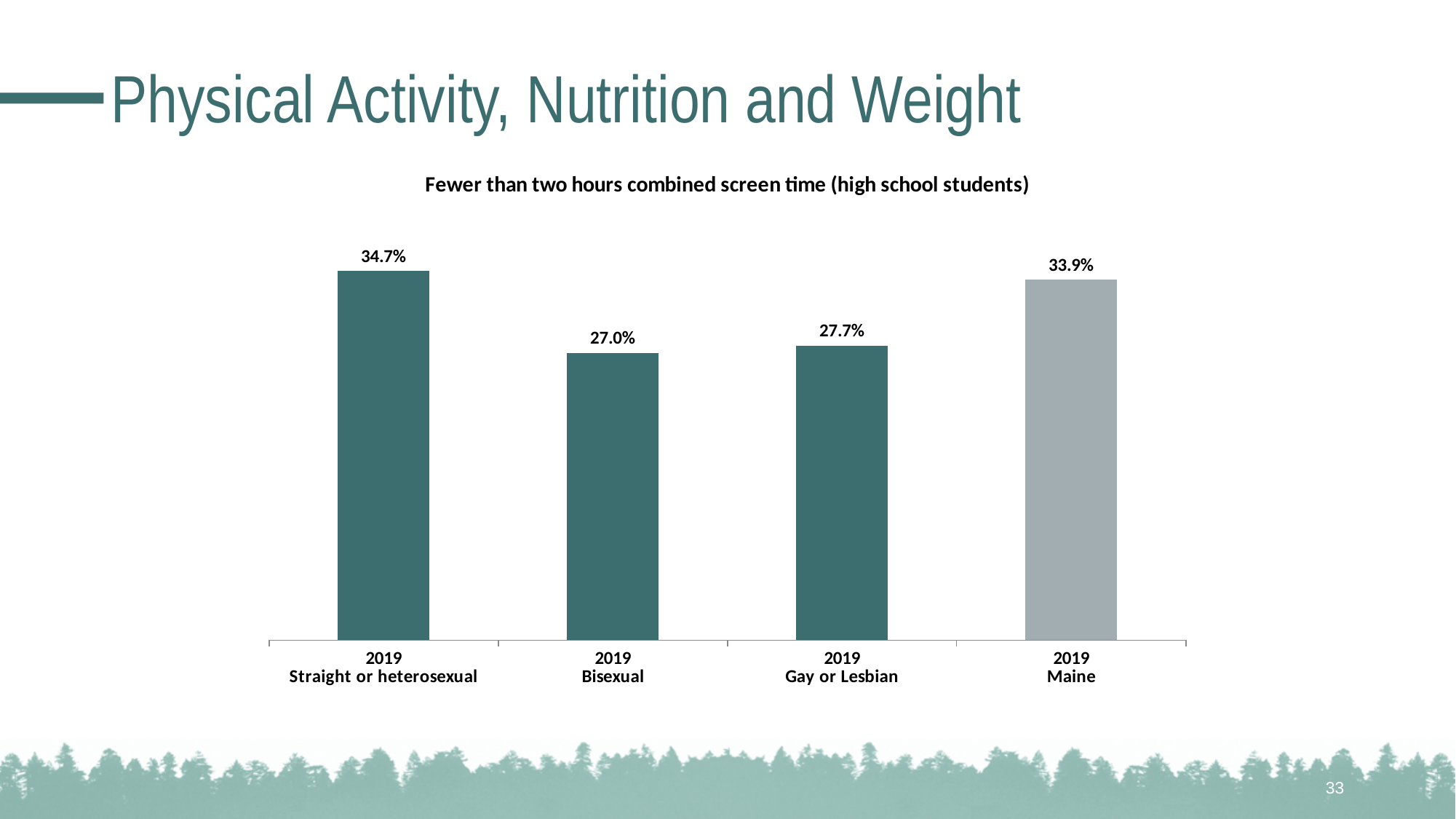
What is the difference between the Straight or heterosexual value and the Bisexual value? 7.7% What kind of chart is shown on the slide? Bar chart What is the value for Gay or Lesbian students in 2019? 27.7% How many bars are shown in the chart? 4 What is the title of the chart? Fewer than two hours combined screen time (high school students) What is the value for Bisexual students in 2019? 27.0% What is the value for Straight or heterosexual students in 2019? 34.7% Which category has the lowest value? Bisexual Which is larger, the value for Straight or heterosexual or the value for Maine? Straight or heterosexual What is the value for Maine in 2019? 33.9% Which category has the highest value? Straight or heterosexual What is the difference between the Maine value and the Gay or Lesbian value? 6.2%